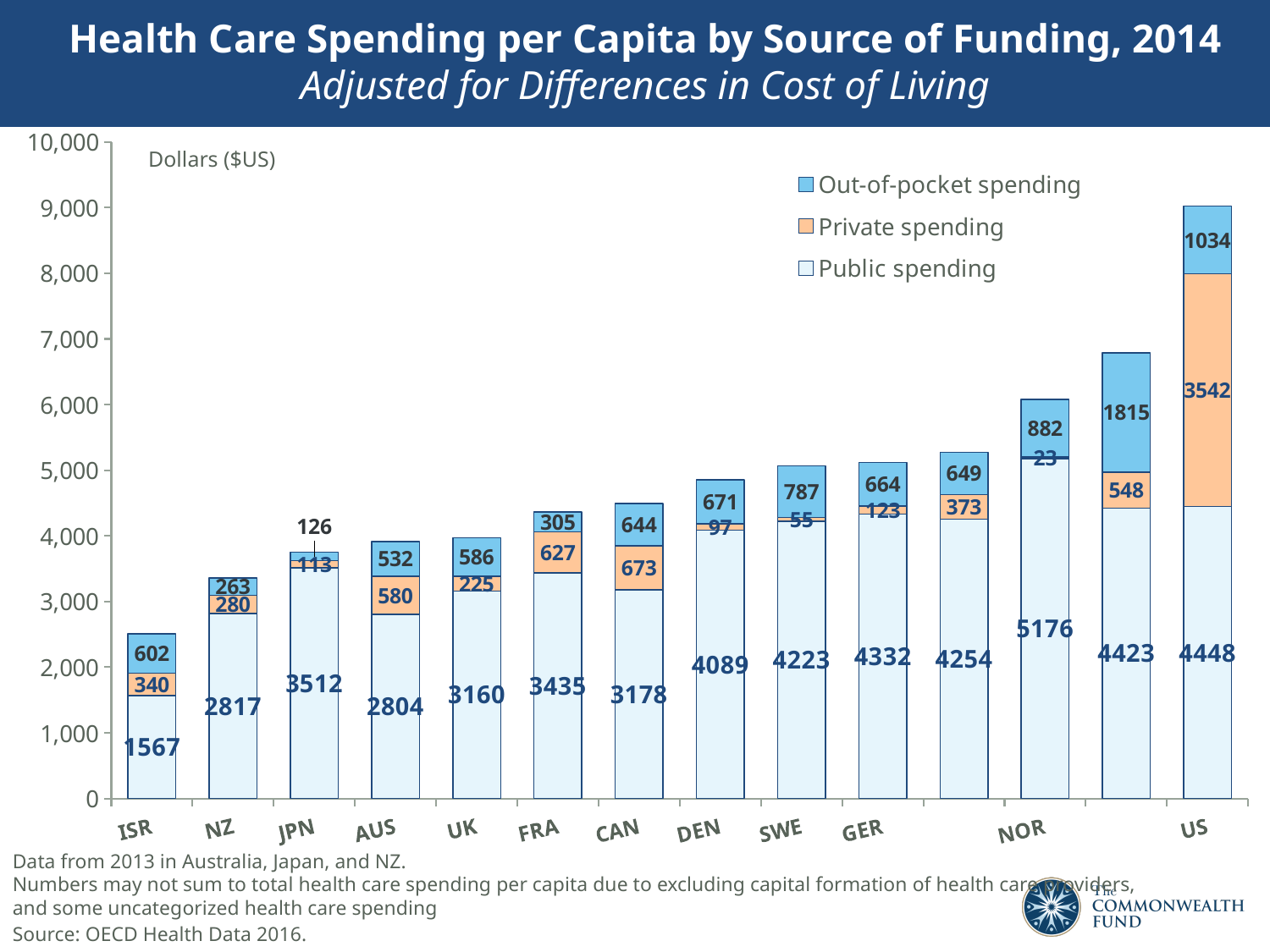
How many series does the legend list? 3 Which country has the lowest public spending? ISR How many bars are plotted in the chart? 14 What kind of chart is shown on the slide? Stacked bar chart Which has higher out-of-pocket spending, SWE or GER? SWE What is the difference between private spending in the US and in FRA? 2915 What is the out-of-pocket spending value for ISR? 602 What is the total of the stacked bar for ISR? 2509 What is the private spending value for FRA? 627 What is the public spending value for the US? 4448 Which country has the highest public spending? NOR Is the total of the stacked bar for JPN greater or less than 4,000? less